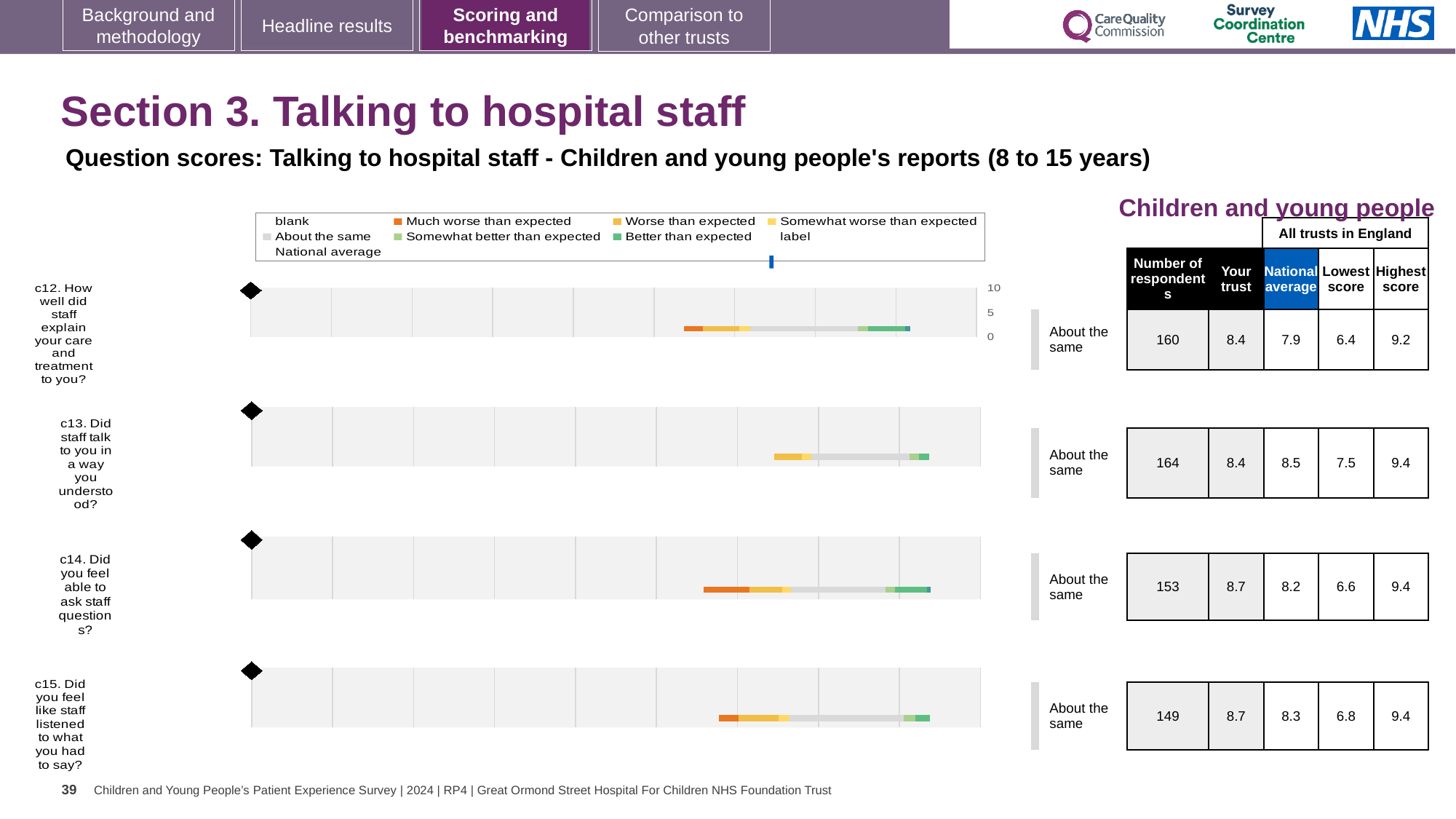
For c12, what is the difference between the highest score (9.2) and the lowest score (6.4) in the table? 2.8 For c14, how much higher is the 'Your trust' score (8.7) than the national average (8.2)? 0.5 Which question has the lowest 'Lowest score' value in the table? c12 Which question has the highest number of respondents in the table? c13 What benchmark category is shown for c15 (Did you feel like staff listened to what you had to say?)? About the same In the table next to the charts, what is the number of respondents for c12 (How well did staff explain your care and treatment to you?)? 160 In the legend, which category is shown in orange? Much worse than expected How many questions (c12 to c15) have a chart on this slide? 4 For c13, which is larger: the 'Your trust' score or the national average? National average In the table, what is the 'Your trust' score for c14 (Did you feel able to ask staff questions?)? 8.7 What kind of chart is used for the question scores on this slide? bar chart In the table, what is the national average for c13 (Did staff talk to you in a way you understood?)? 8.5